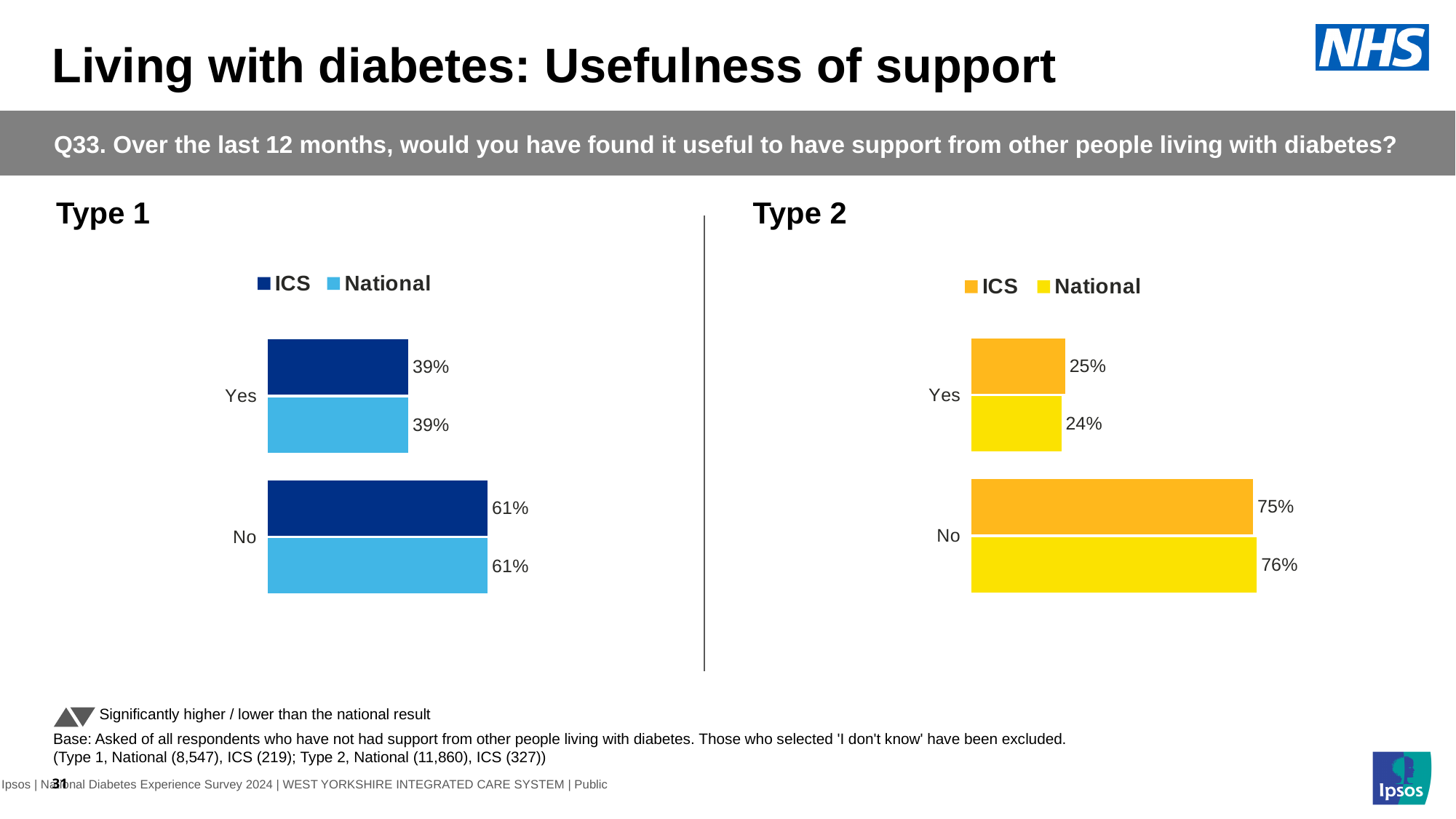
In the Type 2 chart, which is larger for No: the ICS value or the National value? National In the Type 2 chart, which category has the highest ICS value? No In the Type 2 chart, what are the two legend entries? ICS and National In the Type 2 chart, how many series does the legend list? 2 In the Type 1 chart, which category has the lowest National value? Yes In the Type 1 chart, what is the ICS value for Yes? 39% What kind of chart is the Type 1 chart? Bar chart In the Type 1 chart, what is the National value for No? 61% In the Type 2 chart, what is the National value for No? 76% In the Type 2 chart, what is the ICS value for Yes? 25% In the Type 2 chart, what is the difference between the National value for No and the National value for Yes? 52% In the Type 1 chart, how many categories are shown? 2